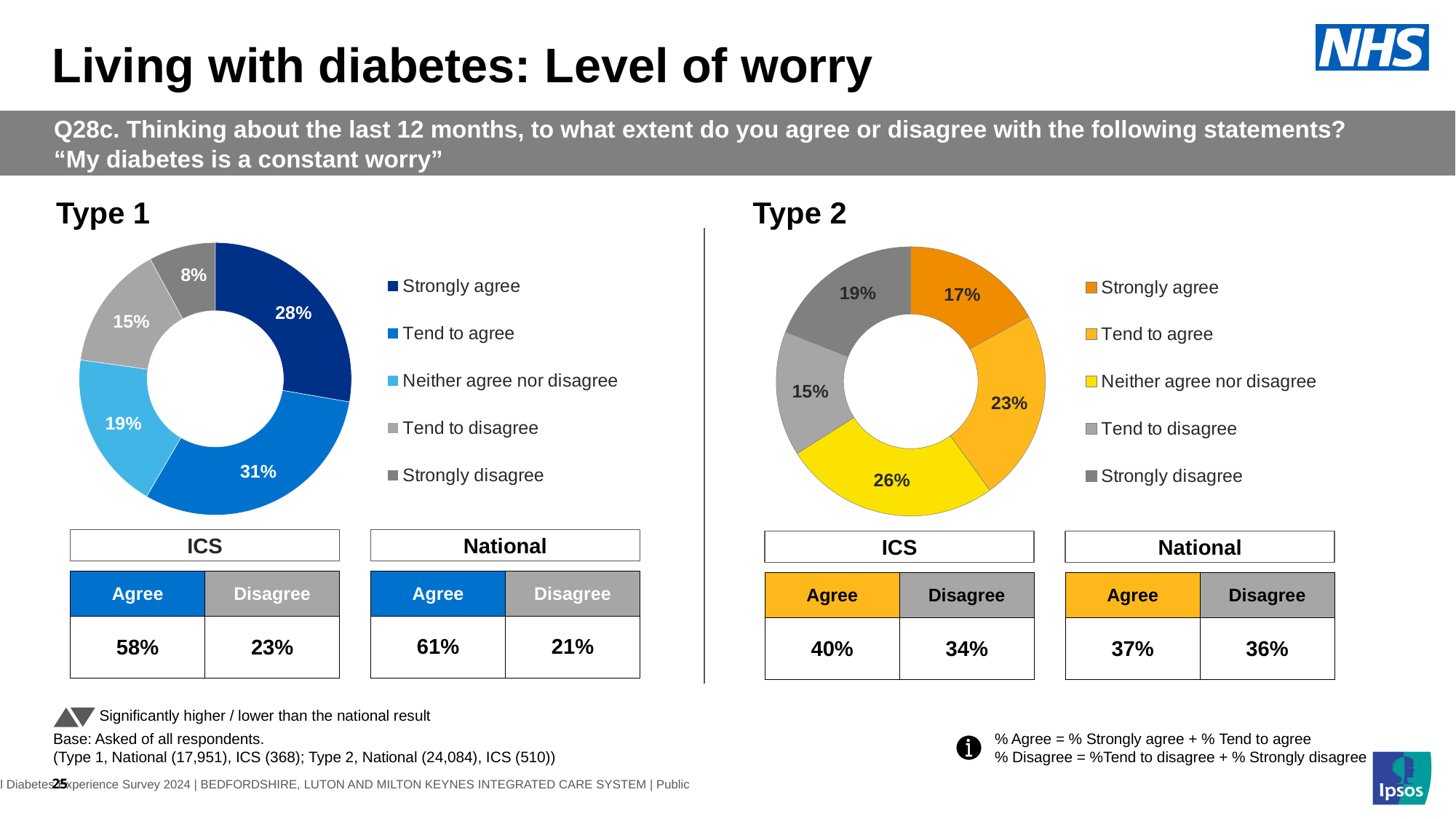
In the Type 1 chart, which response category has the largest share? Tend to agree How many response categories does the legend of the Type 2 chart list? 5 In the Type 2 chart, which is larger: Strongly agree or Tend to agree? Tend to agree In the Type 2 chart, which response category has the smallest share? Tend to disagree In the Type 2 chart, what percentage of respondents neither agree nor disagree? 26% In the Type 1 chart, what percentage of respondents strongly agree? 28% In the Type 1 chart, which response category has the smallest share? Strongly disagree In the Type 1 chart, what is the difference between the Tend to agree and Strongly agree shares? 3% What kind of chart is used for the Type 1 data? Doughnut (pie) chart In the Type 2 chart, which response category has the largest share? Neither agree nor disagree In the Type 2 chart, what percentage of respondents strongly disagree? 19% In the Type 1 chart, what percentage of respondents tend to agree? 31%